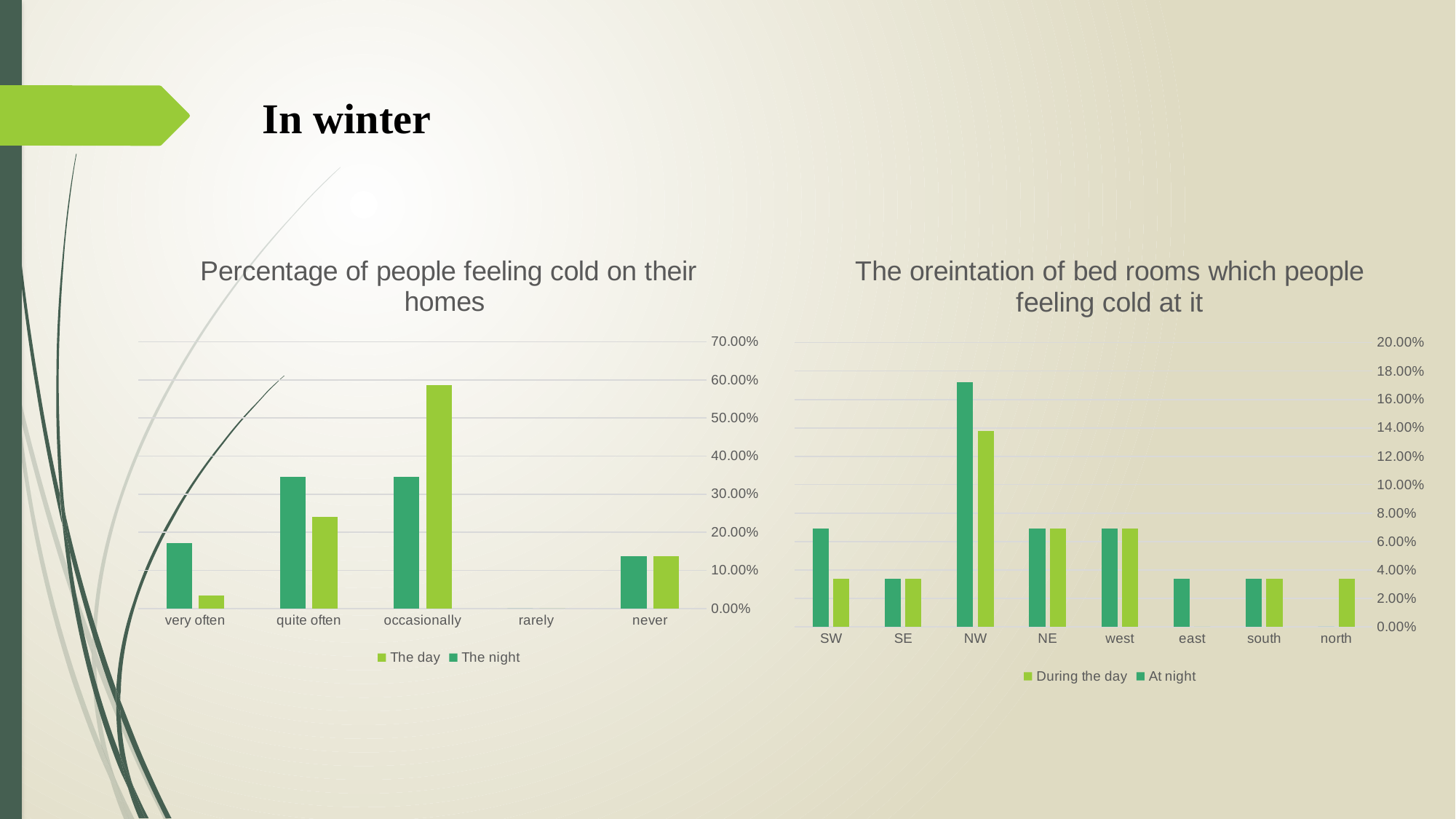
How many series does the legend of the right chart, "The oreintation of bed rooms which people feeling cold at it", list? 2 What type of chart is the left chart titled "Percentage of people feeling cold on their homes"? bar chart How many orientation categories are shown on the x axis of the right chart, "The oreintation of bed rooms which people feeling cold at it"? 8 In the right chart, "The oreintation of bed rooms which people feeling cold at it", for SW, which is larger: During the day or At night? At night In the left chart, "Percentage of people feeling cold on their homes", is the value of The day for occasionally greater or less than 50.00%? greater In the right chart, "The oreintation of bed rooms which people feeling cold at it", is the value of At night for NW greater or less than 14.00%? greater In the left chart, "Percentage of people feeling cold on their homes", for occasionally, which is larger: The day or The night? The day In the right chart, "The oreintation of bed rooms which people feeling cold at it", which orientation has the highest value for At night? NW In the left chart, "Percentage of people feeling cold on their homes", is the value of The night for very often greater or less than 20.00%? less How many categories are shown on the x axis of the left chart, "Percentage of people feeling cold on their homes"? 5 What are the two legend entries of the left chart, "Percentage of people feeling cold on their homes"? The day, The night In the left chart, "Percentage of people feeling cold on their homes", which category has the highest value for The day? occasionally